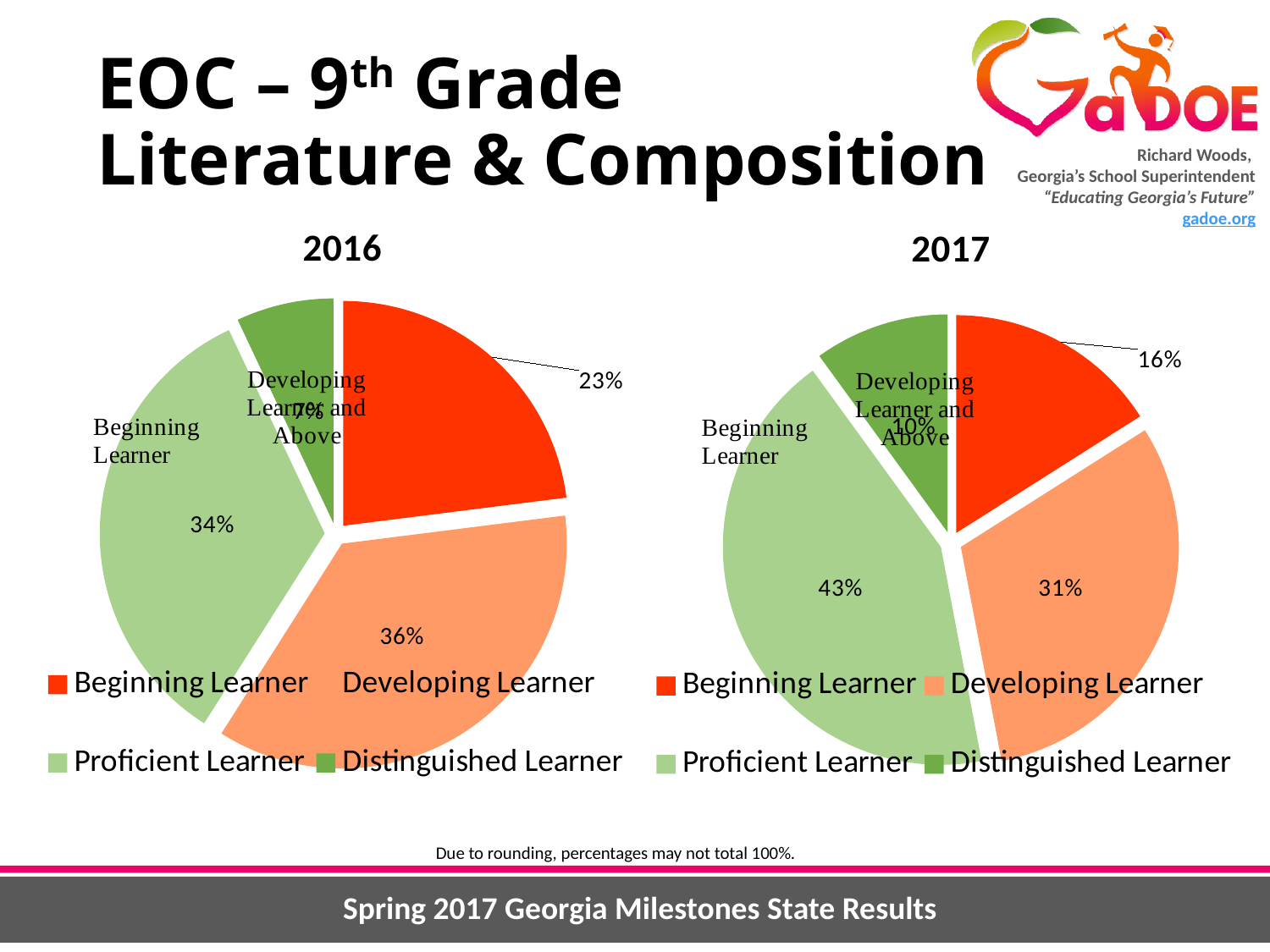
What is the difference in percentage points between the Beginning Learner share in 2016 (23%) and in 2017 (16%)? 7 percentage points How many categories does the legend of the 2017 pie chart list? 4 In the 2016 pie chart, which category has the smallest slice? Distinguished Learner In the 2016 pie chart, what percentage is shown for Developing Learner? 36% What type of chart is used to show the 2016 results? Pie chart In the 2016 pie chart, what percentage is shown for Beginning Learner? 23% In the 2017 pie chart, what percentage is shown for Developing Learner? 31% In the 2017 pie chart, what percentage is shown for Proficient Learner? 43% In the 2017 pie chart, which category has the largest slice? Proficient Learner Is the Beginning Learner percentage larger in the 2016 chart or the 2017 chart? 2016 In the 2017 pie chart, what percentage is shown for Beginning Learner? 16% In the 2016 pie chart, what percentage is shown for Proficient Learner? 34%